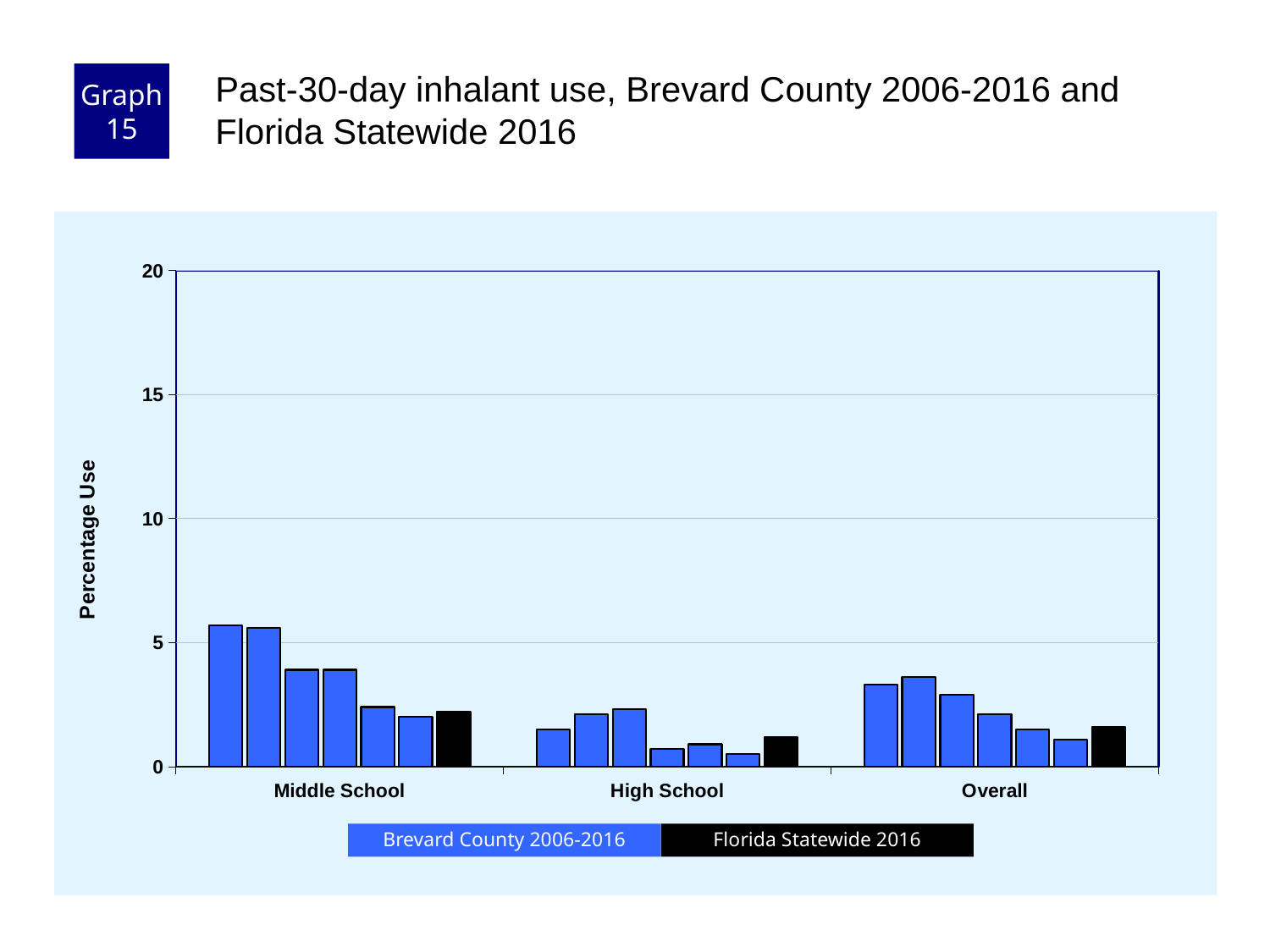
How many school-level categories are shown on the x axis? 3 Is the tallest Middle School bar greater or less than 5? greater What is the label on the y axis? Percentage Use Do the Brevard County bars for Middle School generally rise or fall from 2006 to 2016? fall Is the Florida Statewide 2016 value for High School greater or less than 5? less How many series does the legend list? 2 Which colour represents Florida Statewide 2016 in the legend? black Which is larger, the Florida Statewide 2016 value for Middle School or for High School? Middle School What kind of chart is shown on the slide? bar chart Which category group contains the tallest bar in the chart? Middle School Is the Florida Statewide 2016 value for Overall greater or less than 5? less